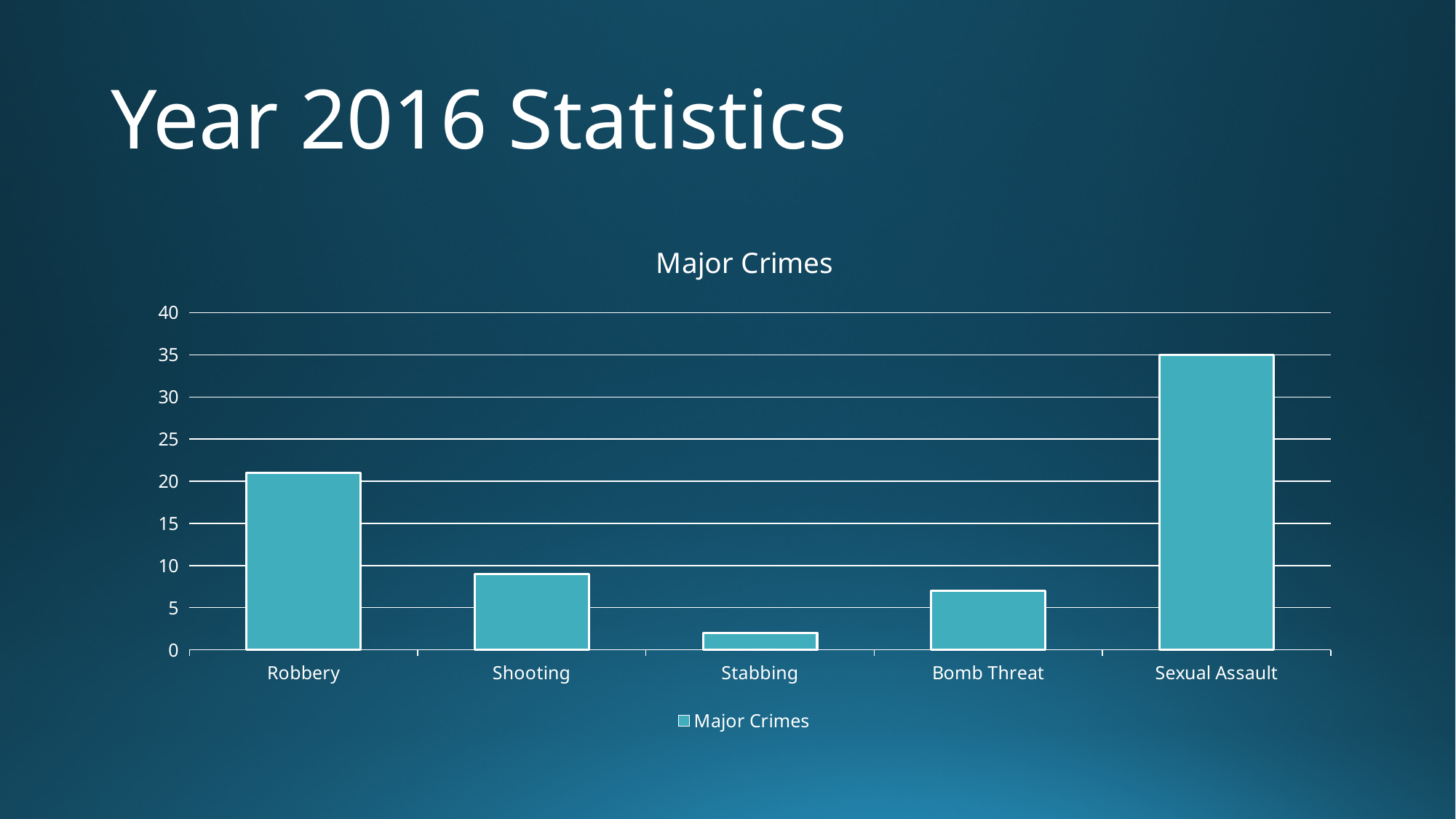
Which category has the lowest value? Stabbing Is the value for Shooting greater or less than 10? less Which is larger, the value for Shooting or the value for Stabbing? Shooting What is the value for Sexual Assault? 35 Which category has the highest value? Sexual Assault How many series does the legend list? 1 What type of chart is shown on the slide? bar chart Is the value for Stabbing greater or less than 5? less Which is larger, the value for Robbery or the value for Bomb Threat? Robbery What is the title of the chart? Major Crimes Is the value for Robbery greater or less than 15? greater How many crime categories are shown on the x axis? 5